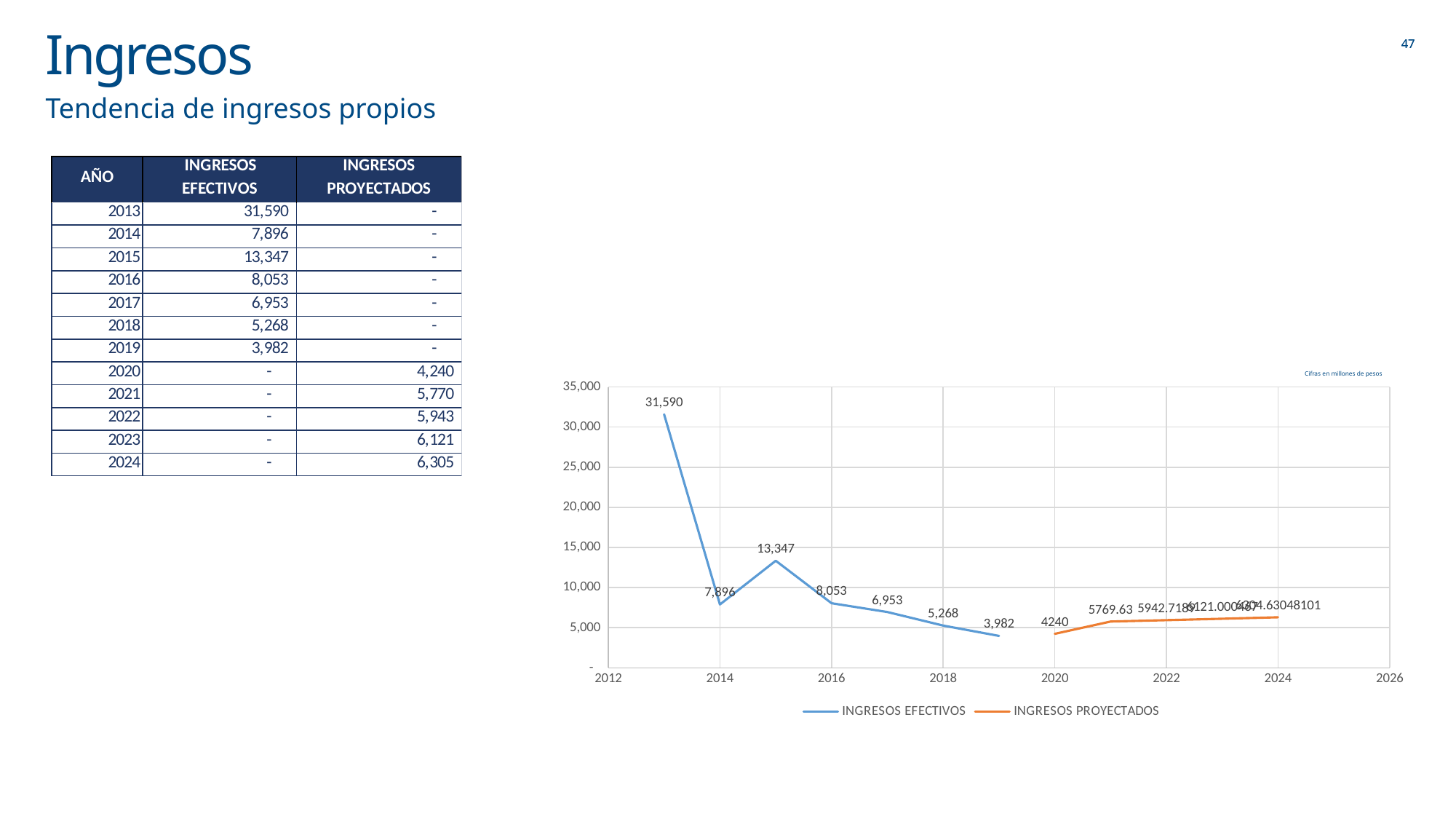
What is the value of INGRESOS EFECTIVOS for 2015 in the chart? 13,347 What is the value of INGRESOS PROYECTADOS for 2020 in the chart? 4240 Which is larger in the chart: INGRESOS EFECTIVOS for 2016 or for 2017? 2016 Does the INGRESOS PROYECTADOS line rise or fall from 2020 to 2024? rise What type of chart is shown on the slide? line chart How many series does the chart legend list? 2 Which year has the lowest value of INGRESOS EFECTIVOS in the chart? 2019 What is the value of INGRESOS EFECTIVOS for 2013 in the chart? 31,590 What is the value of INGRESOS EFECTIVOS for 2019 in the chart? 3,982 Which year has the highest value of INGRESOS EFECTIVOS in the chart? 2013 What is the difference between the INGRESOS EFECTIVOS values for 2013 and 2014 in the chart? 23,694 What is the value of INGRESOS PROYECTADOS for 2021 in the chart? 5769.63